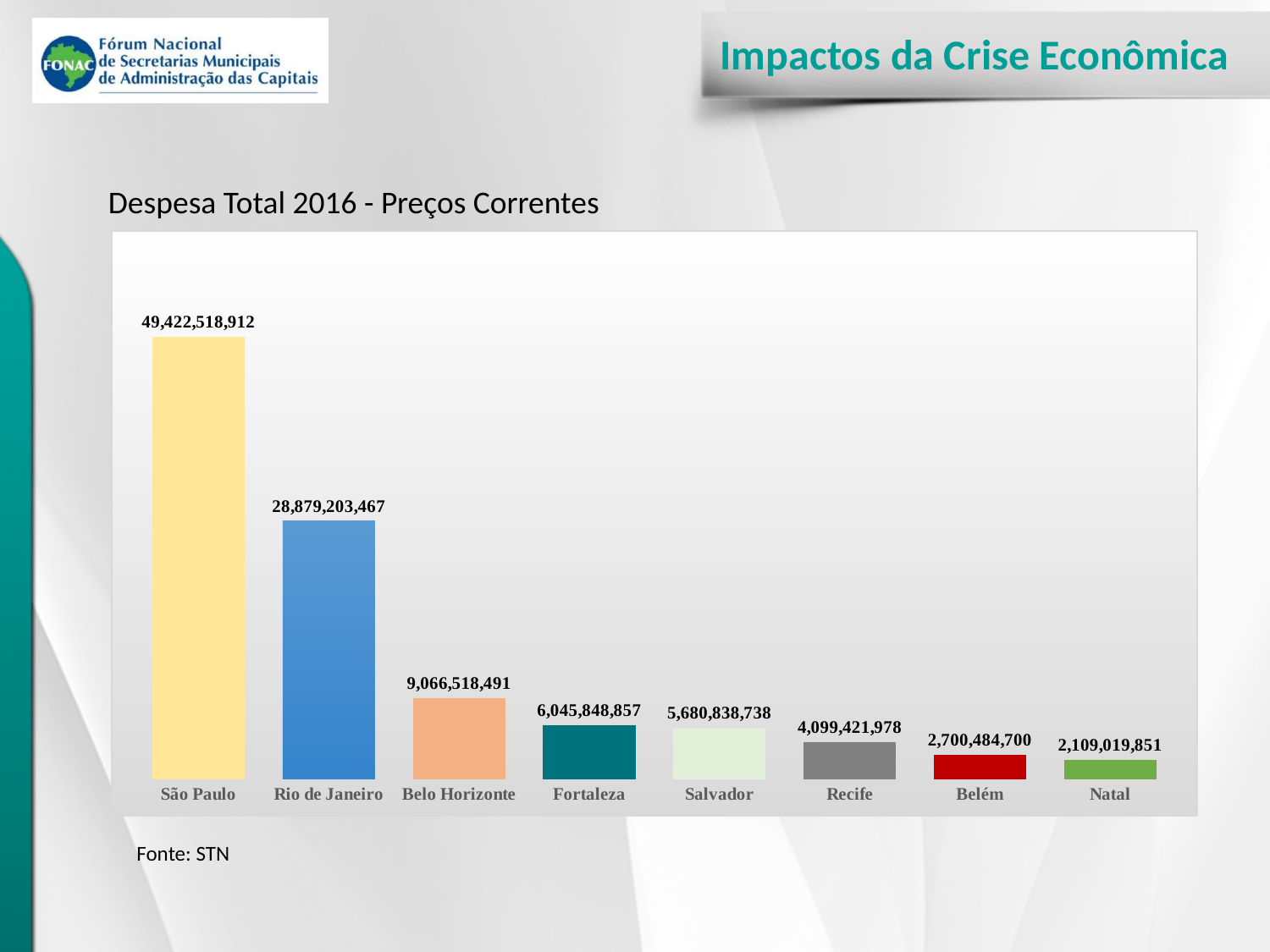
What is the difference between the values for São Paulo and Rio de Janeiro? 20,543,315,445 Do the values rise or fall from left to right along the x axis? Fall What is the value for São Paulo? 49,422,518,912 What is the value for Recife? 4,099,421,978 How many cities are shown in the chart? 8 What is the value for Belém? 2,700,484,700 Which is larger, the value for Salvador or the value for Recife? Salvador Which city has the lowest value? Natal What is the value for Fortaleza? 6,045,848,857 What kind of chart is this? Bar chart What is the difference between the values for Belém and Natal? 591,464,849 Which city has the highest value? São Paulo